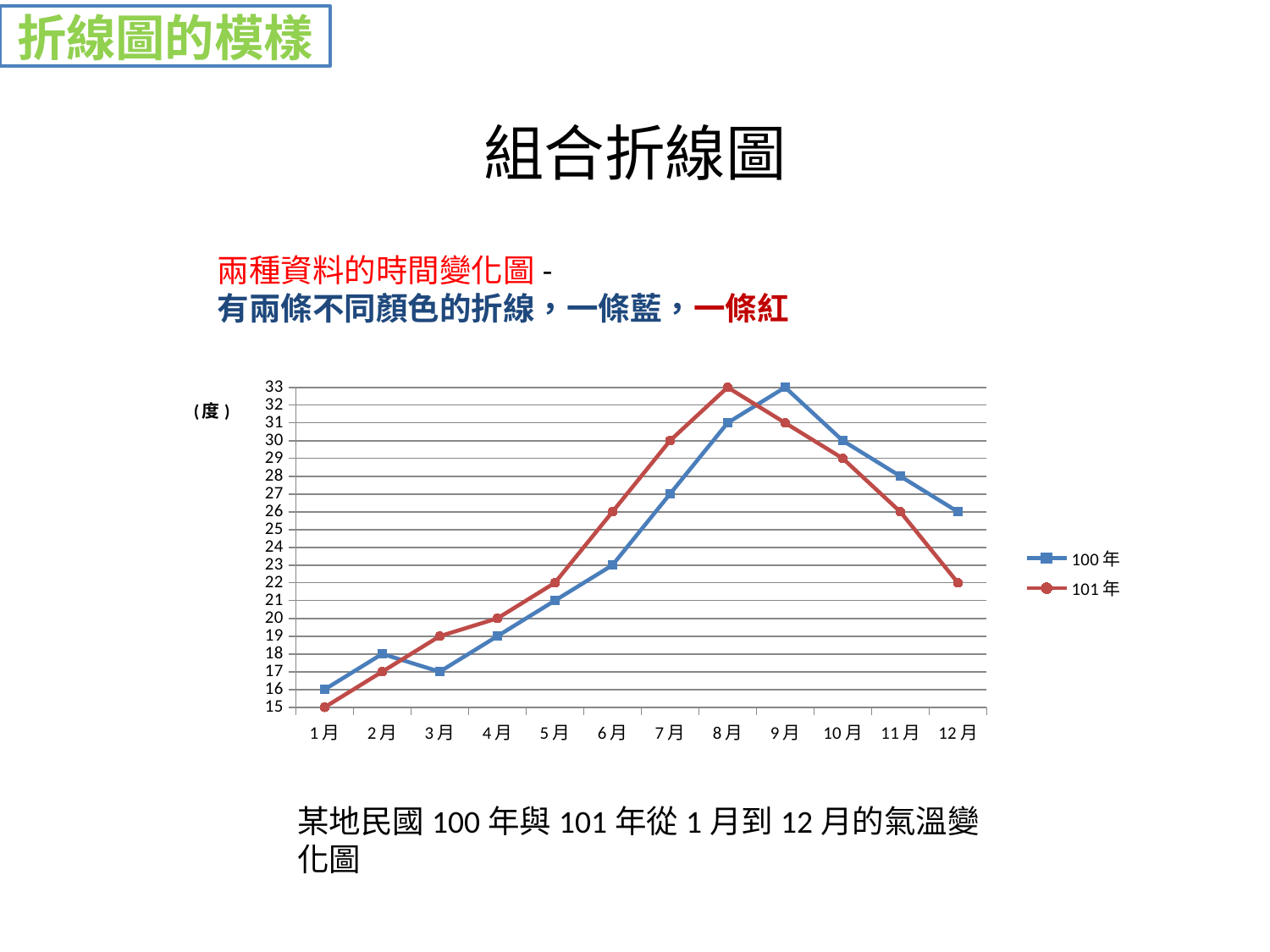
In which month is the 100年 series at its lowest value? 1月 Which series has the larger value in 7月, 100年 or 101年? 101年 What type of chart is shown on the slide? line chart Which colour is used for the 101年 series? red How many series does the legend list? 2 How many months are plotted along the x axis? 12 What is the value for 101年 in 12月? 22 What is the difference between the 100年 and 101年 values in 12月? 4 Is the value for 100年 in 6月 greater or less than 25? less What is the value for 100年 in 9月? 33 What is the value for 101年 in 1月? 15 In which month does the 101年 series reach its highest value? 8月